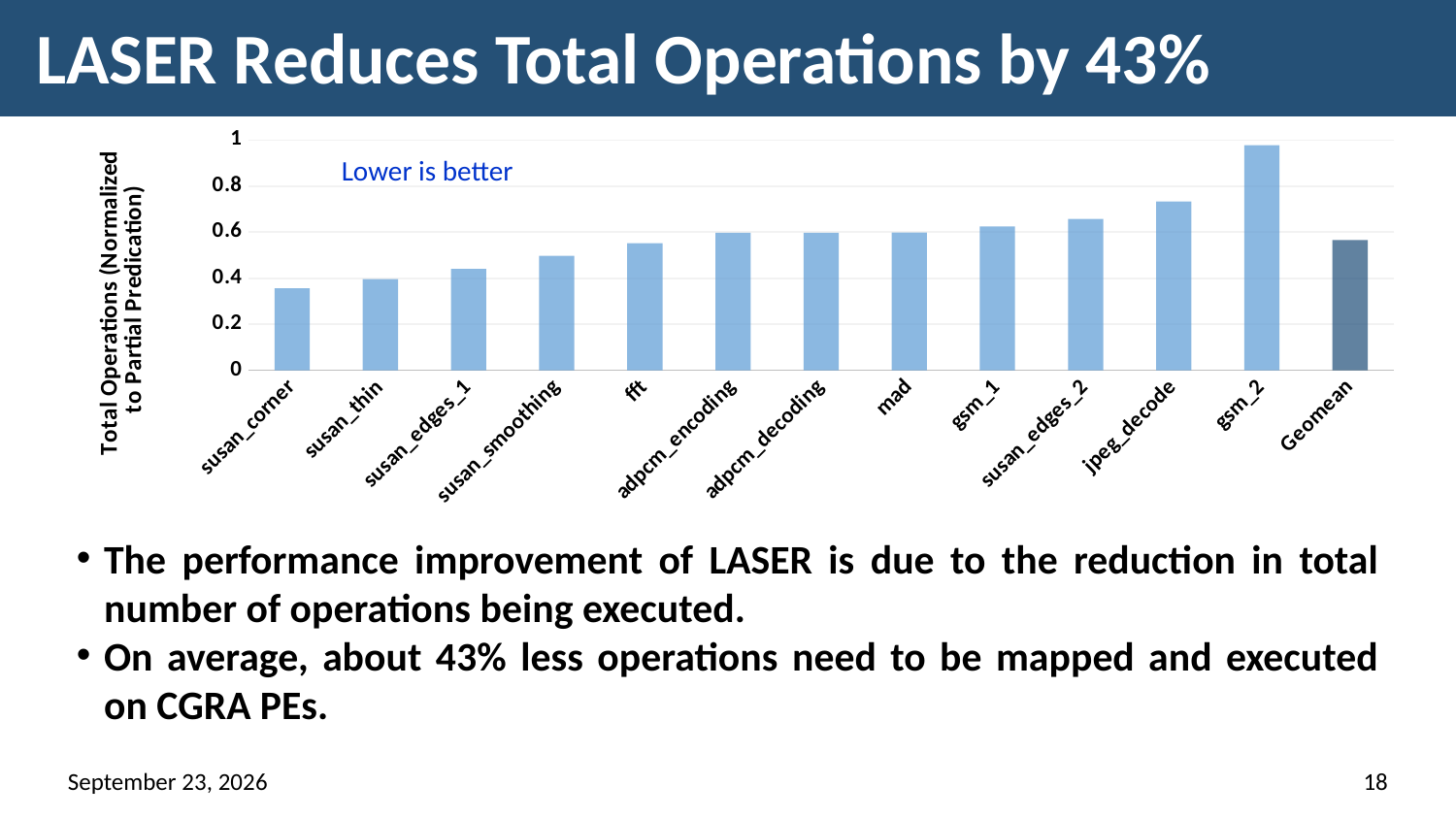
Is the value for susan_corner greater or less than 0.4? less What annotation text is written inside the plot area of the chart? Lower is better Which is larger, the value for jpeg_decode or the value for fft? jpeg_decode Is the value for jpeg_decode greater or less than 0.6? greater What kind of chart is shown on the slide? bar chart What is the label of the y axis of the chart? Total Operations (Normalized to Partial Predication) Do the bars for the benchmarks from susan_corner to gsm_2 generally rise or fall from left to right? rise How many categories are plotted along the x axis of the chart? 13 Is the value for Geomean greater or less than 0.4? greater Which category has the highest bar in the chart? gsm_2 Which category has the lowest bar in the chart? susan_corner